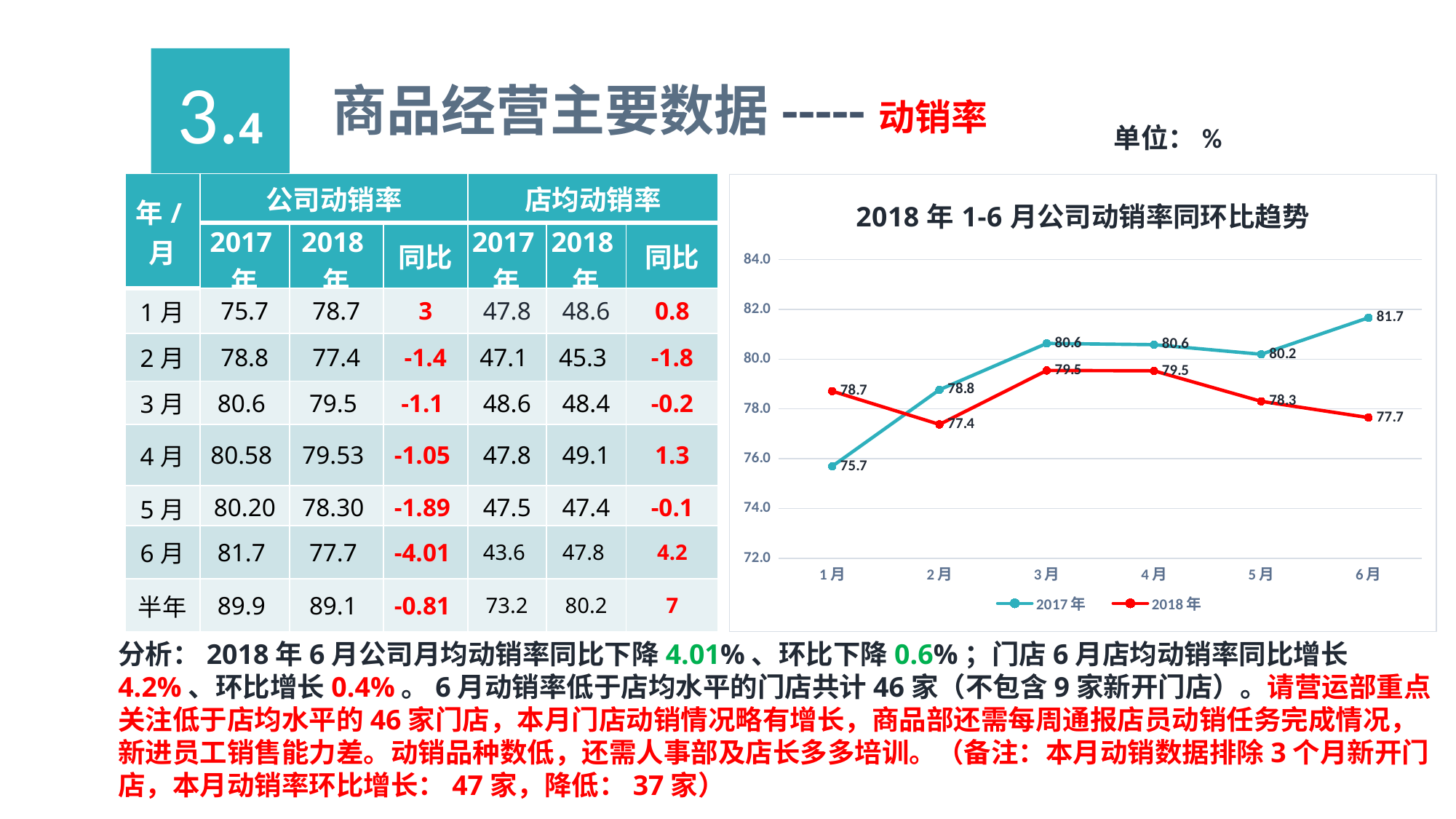
How many months are plotted along the x axis of the chart? 6 What is the value for 2018年 in 1月? 78.7 What is the difference between the 2017年 and 2018年 values in 6月? 4.0 In 1月, which series has the larger value, 2017年 or 2018年? 2018年 How many series does the chart's legend list? 2 What type of chart is shown on the slide? line chart What is the value for 2017年 in 6月? 81.7 Which month has the highest value for the 2017年 series? 6月 Does the 2018年 series rise or fall from 4月 to 6月? fall What is the title of the chart? 2018年1-6月公司动销率同环比趋势 What is the value for 2018年 in 2月? 77.4 Which month has the lowest value for the 2017年 series? 1月